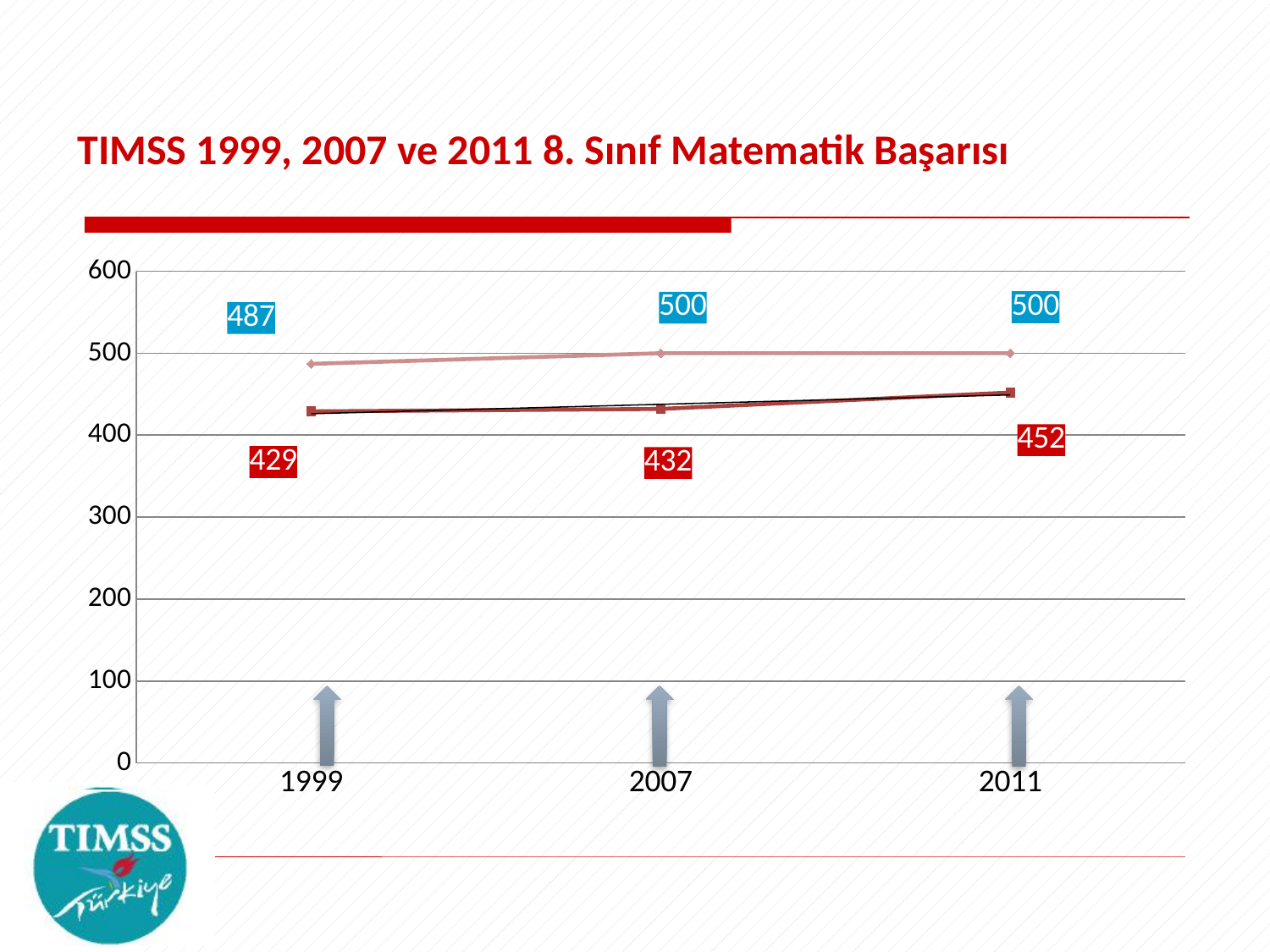
In which year is the lower line (red labels) at its highest value? 2011 What is the title of the chart on the slide? TIMSS 1999, 2007 ve 2011 8. Sınıf Matematik Başarısı What is the value of the lower line (red labels) in 2007? 432 By how much did the lower line (red labels) increase from 1999 to 2011? 23 What is the value of the upper line (blue labels) in 1999? 487 What is the value of the lower line (red labels) in 2011? 452 What kind of chart is shown on the slide? line chart What is the difference between the upper line and the lower line in 2011? 48 How many years are shown on the x axis? 3 What is the value of the lower line (red labels) in 1999? 429 Does the lower line (red labels) rise or fall from 1999 to 2011? rise What is the value of the upper line (blue labels) in 2007? 500